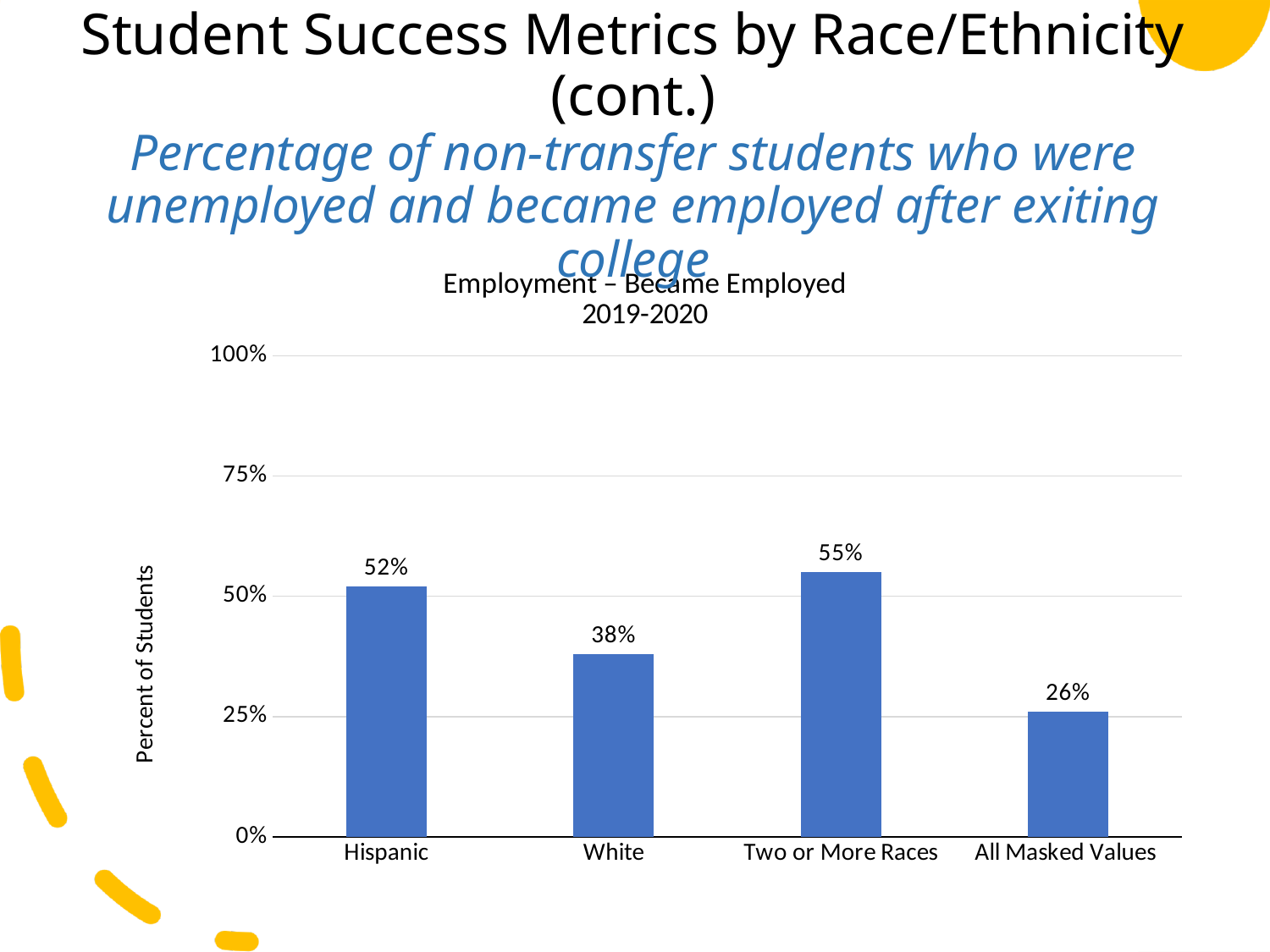
What kind of chart is shown on the slide? Bar chart What is the value for Hispanic? 52% What is the difference between the values for Hispanic and White? 14% What is the value for All Masked Values? 26% What is the difference between the values for Two or More Races and All Masked Values? 29% What is the value for Two or More Races? 55% How many categories are shown on the x axis? 4 Which is larger, the value for Hispanic or the value for White? Hispanic Which category has the highest value? Two or More Races Which category has the lowest value? All Masked Values What is the y-axis label of the chart? Percent of Students What is the value for White? 38%